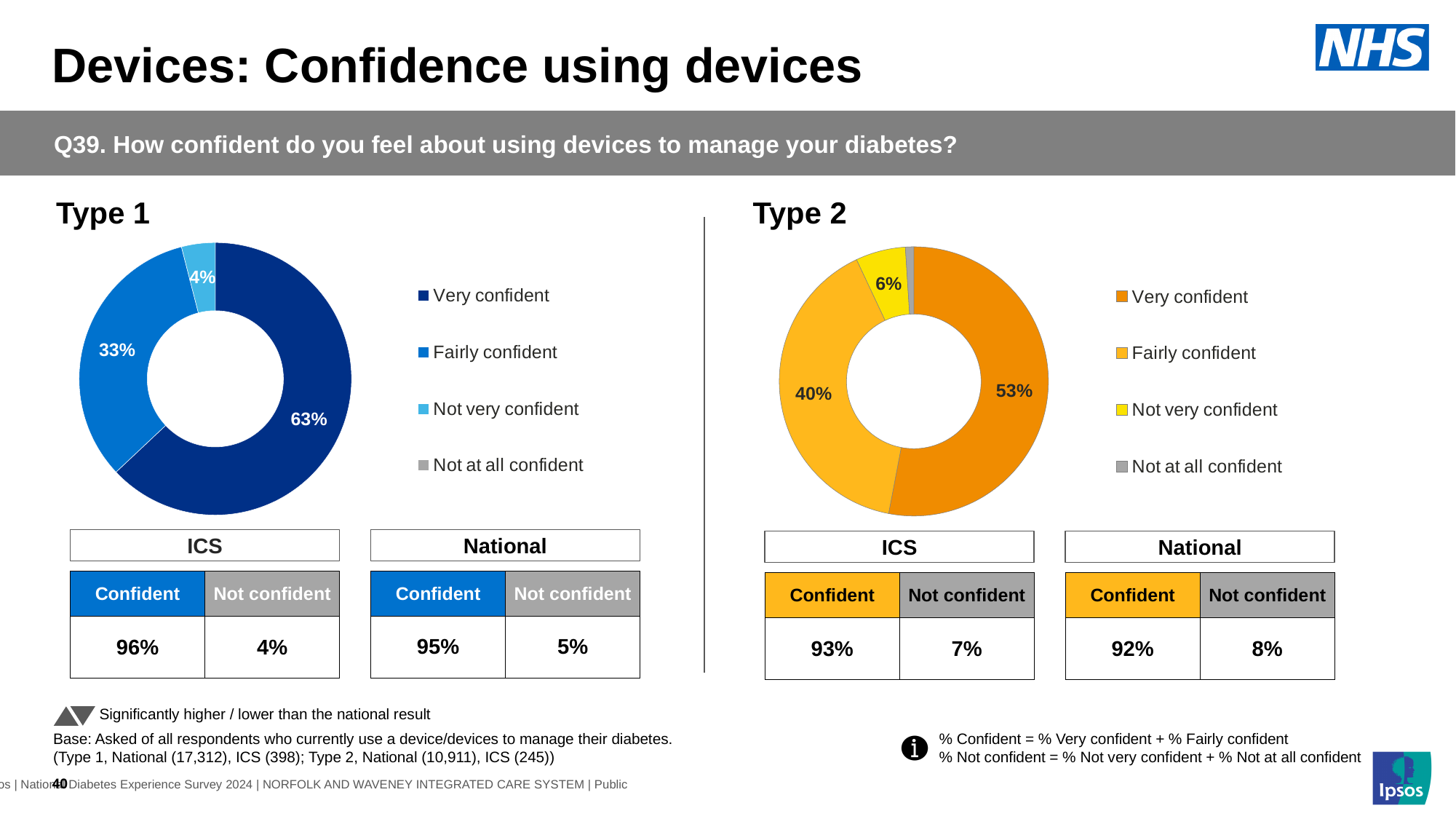
In the Type 1 chart, which category has the largest share? Very confident In the Type 2 chart, which category has the largest share? Very confident In the Type 2 chart, what percentage of respondents are not very confident? 6% In the Type 2 chart, what percentage of respondents are very confident? 53% What type of chart is used for Type 1 and Type 2? Donut (pie) chart Is the very confident share larger in the Type 1 chart or the Type 2 chart? Type 1 In the Type 1 chart, what percentage of respondents are very confident? 63% In the Type 1 chart, what percentage of respondents are not very confident? 4% In the Type 1 chart, what percentage of respondents are fairly confident? 33% In the Type 2 chart, what is the difference between the very confident and fairly confident shares? 13% In the Type 2 chart, what percentage of respondents are fairly confident? 40% In the Type 1 chart, what is the difference between the very confident and fairly confident shares? 30%